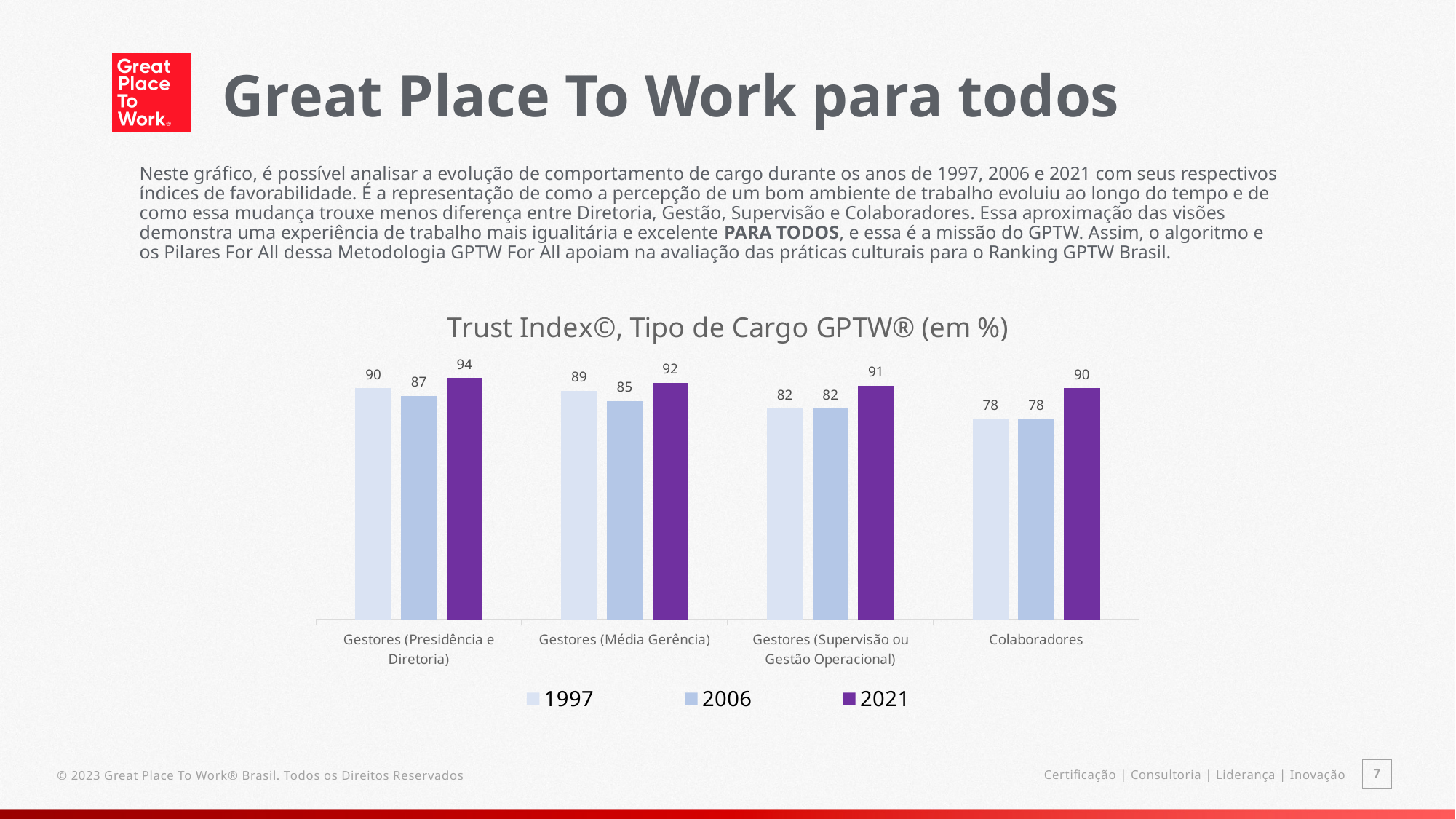
What is the 1997 value for Gestores (Média Gerência)? 89 What is the difference between the 2021 and 1997 values for Colaboradores? 12 How many series does the legend list? 3 Which category has the highest 2021 value? Gestores (Presidência e Diretoria) Do the 2021 values rise or fall moving from Gestores (Presidência e Diretoria) to Colaboradores? Fall What kind of chart is this? Bar chart Which is larger for Gestores (Presidência e Diretoria): the 1997 value or the 2006 value? 1997 What is the 2006 value for Gestores (Supervisão ou Gestão Operacional)? 82 What is the title of the chart? Trust Index©, Tipo de Cargo GPTW® (em %) Which category has the lowest 1997 value? Colaboradores What is the 2021 value for Colaboradores? 90 How many categories are shown on the x axis? 4